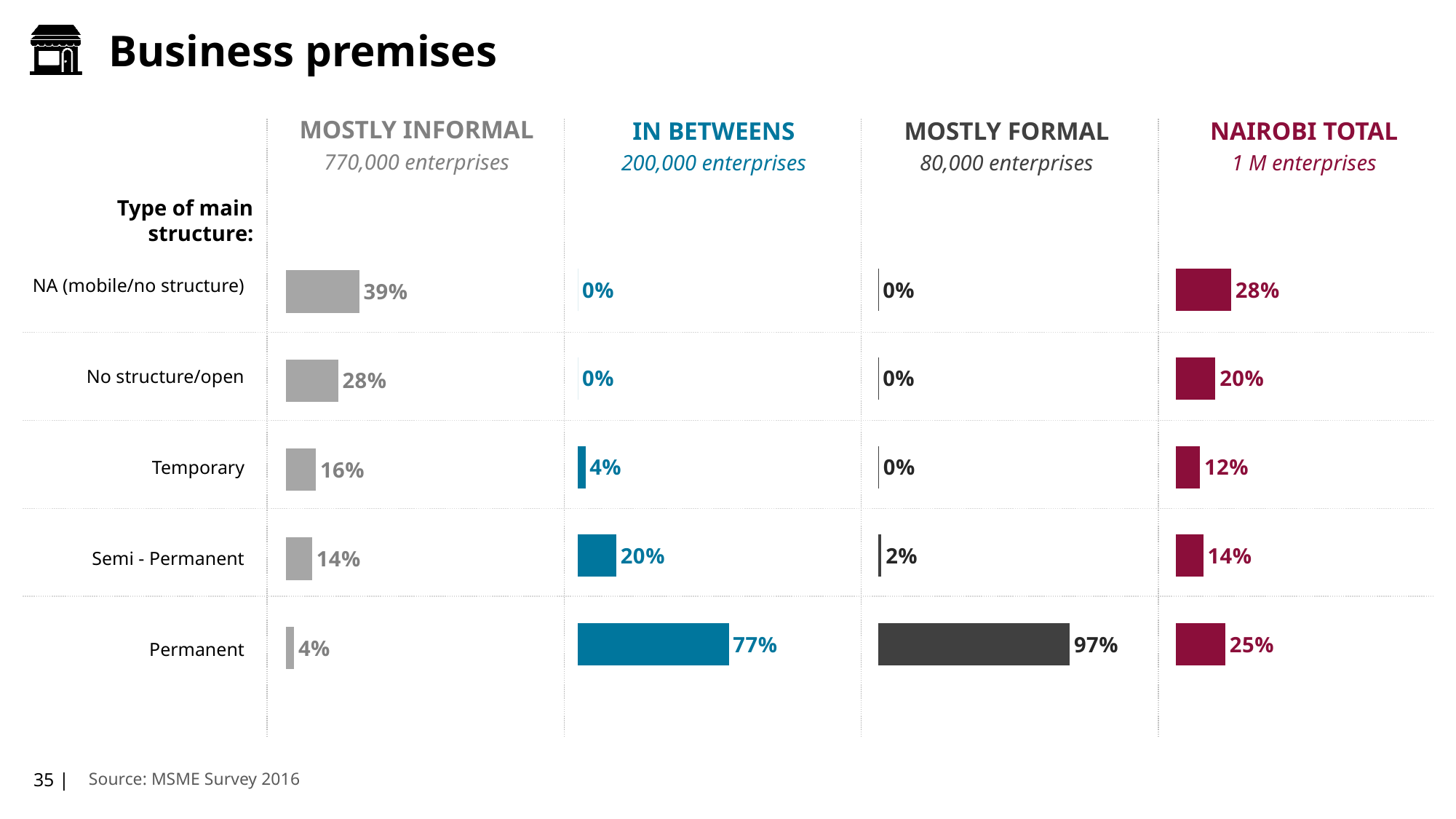
In the Mostly Informal chart, which type of main structure has the lowest value? Permanent In the In Betweens chart, which is larger: Semi - Permanent or Temporary? Semi - Permanent In the Nairobi Total chart, what is the value for Temporary? 12% In the Mostly Formal chart, what is the value for Semi - Permanent? 2% In the Mostly Informal chart, what is the value for NA (mobile/no structure)? 39% In the Mostly Formal chart, which type of main structure has the highest value? Permanent What kind of chart is used to show the values on this slide? Bar chart In the Mostly Informal chart, what is the difference between NA (mobile/no structure) and No structure/open? 11% How many enterprises does the In Betweens column header say it covers? 200,000 enterprises In the In Betweens chart, what is the value for Permanent? 77% In the Nairobi Total chart, which type of main structure has the highest value? NA (mobile/no structure) How many types of main structure are shown in each chart? 5